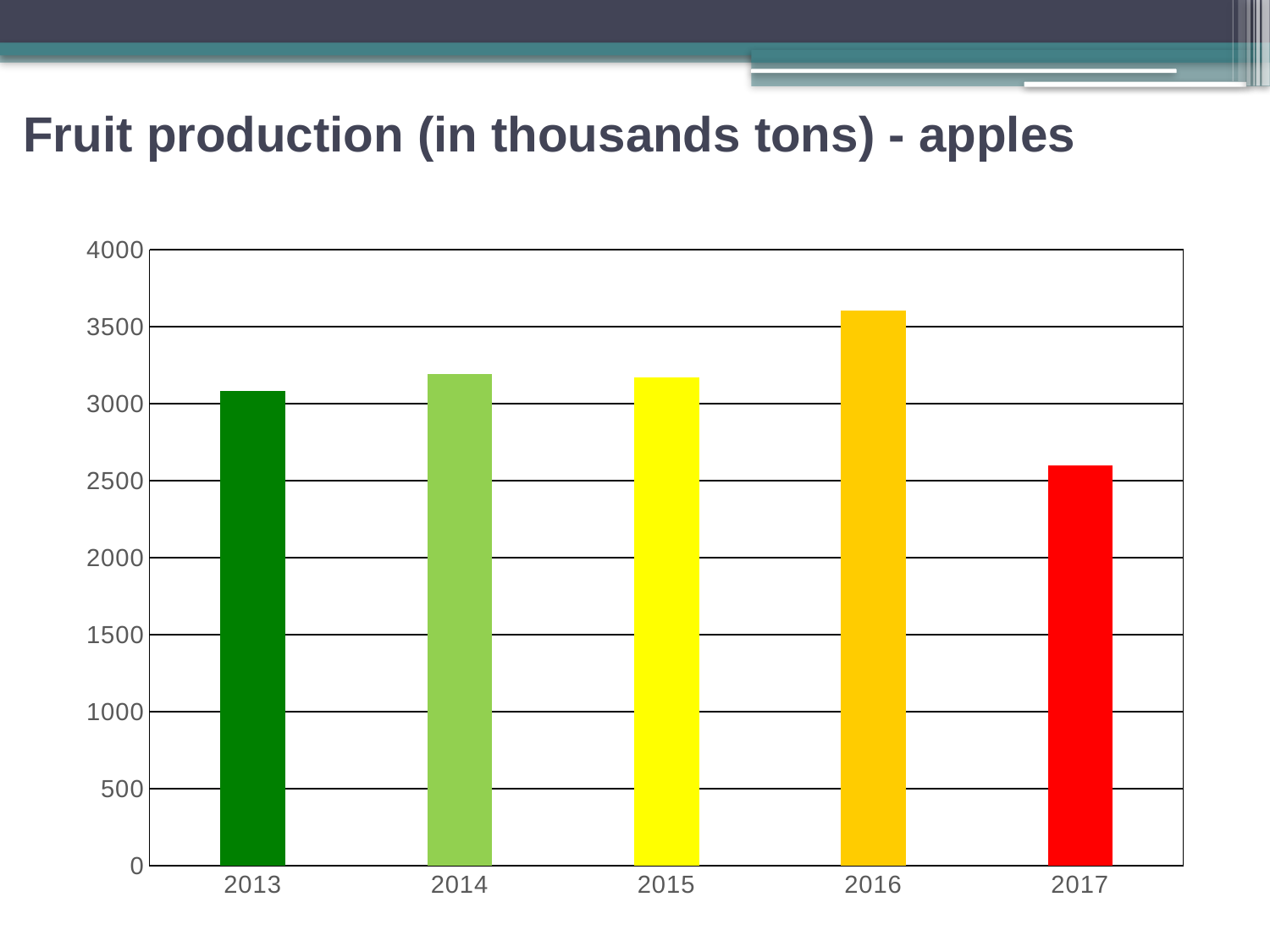
Is the value for 2016 greater or less than 4000? less Which year has the lowest apple production? 2017 How many years are shown on the x axis of the chart? 5 Which year has the highest apple production? 2016 Is the value for 2017 greater or less than 2500? greater Is the value for 2017 greater or less than 3000? less What kind of chart is shown on the slide? bar chart Which is larger, the value for 2016 or the value for 2017? 2016 Which is larger, the value for 2013 or the value for 2017? 2013 What is the title of the slide containing the chart? Fruit production (in thousands tons) - apples